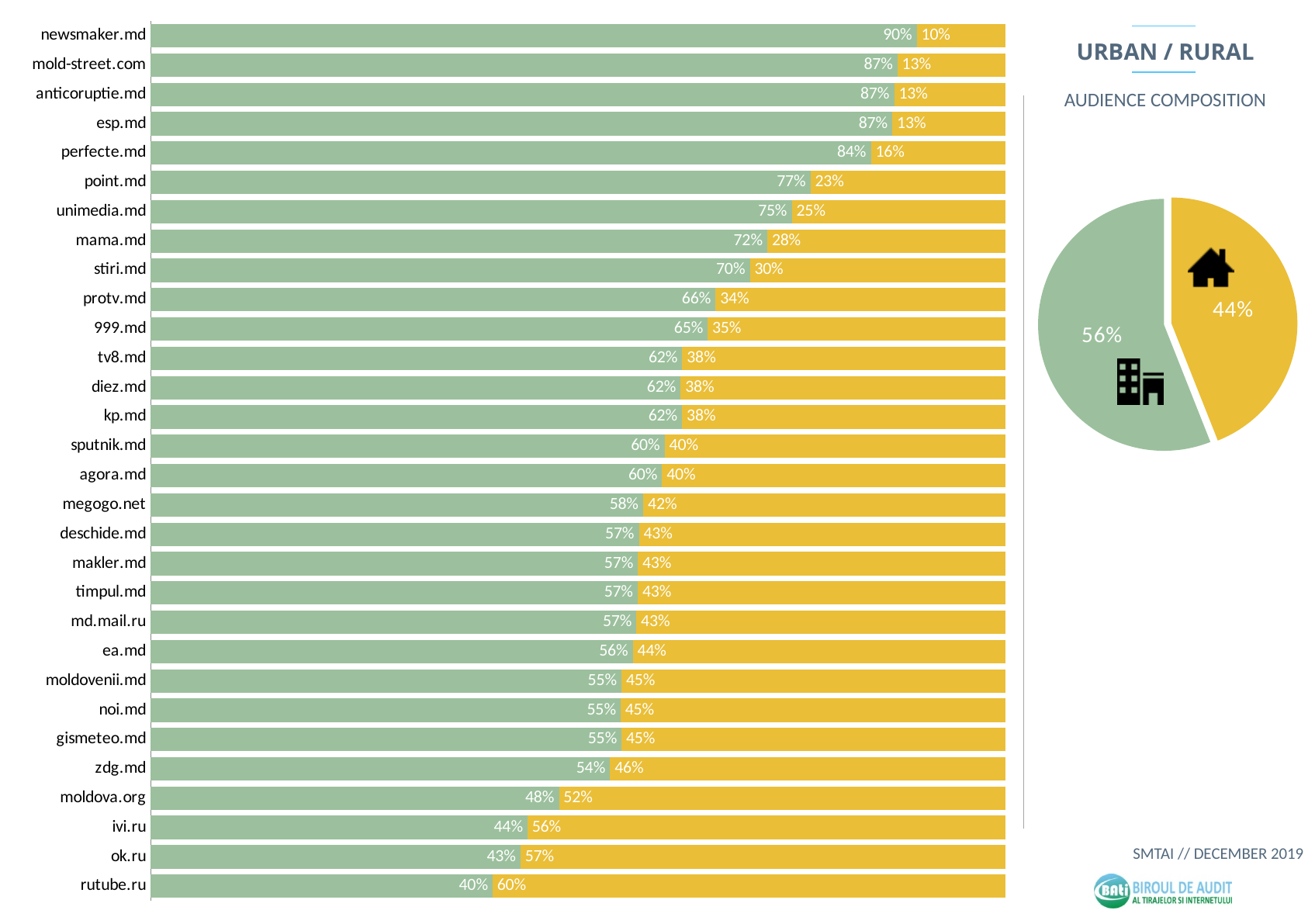
What kind of chart is the chart on the left of the slide? Stacked bar chart What is the title shown above the pie chart? URBAN / RURAL In the bar chart, what is the value of the green segment for newsmaker.md? 90% In the pie chart, what share does the green slice represent? 56% In the bar chart, which site has the smallest green segment? rutube.ru In the bar chart, what is the difference between the green and yellow segments for point.md? 54 percentage points In the bar chart, what is the total of the stacked bar for mama.md? 100% In the bar chart, what is the value of the yellow segment for perfecte.md? 16% In the bar chart, what is the value of the yellow segment for rutube.ru? 60% In the bar chart, which site has a larger green segment, stiri.md or protv.md? stiri.md In the bar chart, which site has the largest green segment? newsmaker.md How many sites are listed in the bar chart? 30